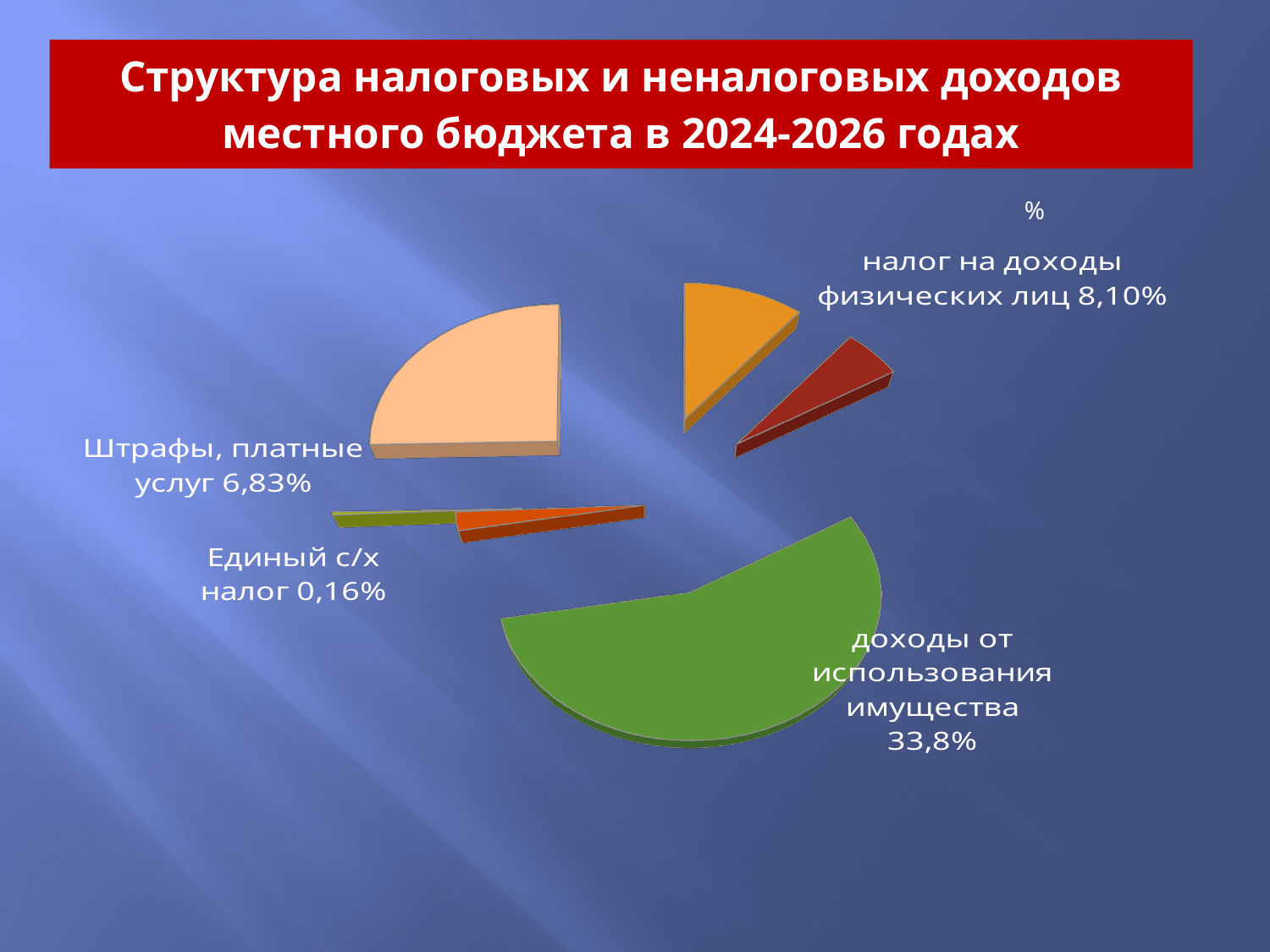
How many slices does the pie chart have? 6 Which is larger: the share of "налог на доходы физических лиц" or the share of "Штрафы, платные услуг"? налог на доходы физических лиц What is the title of the slide containing the pie chart? Структура налоговых и неналоговых доходов местного бюджета в 2024-2026 годах What share is shown for "Штрафы, платные услуг"? 6,83% What is the difference between the shares of "доходы от использования имущества" and "налог на доходы физических лиц"? 25,7% What share is shown for "Единый с/х налог"? 0,16% Which labelled category has the largest share in the pie chart? доходы от использования имущества What is the difference between the shares of "налог на доходы физических лиц" and "Штрафы, платные услуг"? 1,27% What type of chart is shown on the slide? pie chart What share is shown for "налог на доходы физических лиц"? 8,10% Which labelled category has the smallest share in the pie chart? Единый с/х налог What share is shown for "доходы от использования имущества"? 33,8%